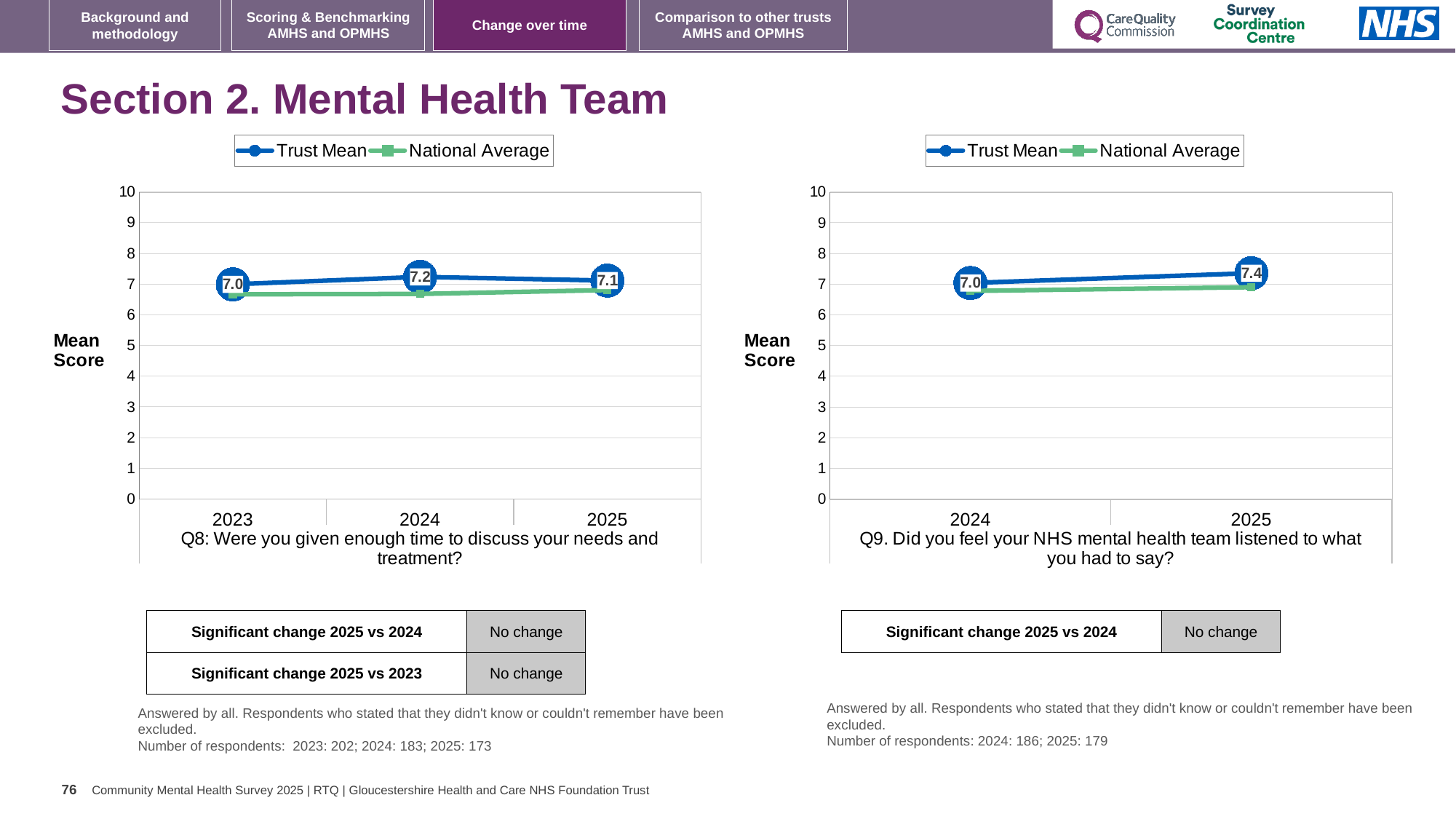
In the Q9 chart on the right, does the Trust Mean rise or fall from 2024 to 2025? rise In the Q9 chart on the right, what is the Trust Mean for 2025? 7.4 How many years are shown on the x axis of the Q8 chart on the left? 3 In the Q8 chart on the left, what is the Trust Mean for 2023? 7.0 In the Q9 chart on the right, what is the difference between the Trust Mean for 2025 and 2024? 0.4 In the Q9 chart on the right, is the National Average for 2025 greater or less than 8? less In the Q8 chart on the left, which year has the highest Trust Mean? 2024 In the Q8 chart on the left, which year has the lowest Trust Mean? 2023 How many series does the legend of the Q9 chart on the right list? 2 What kind of chart is used for Q9 on the right? line chart In the Q8 chart on the left, what is the Trust Mean for 2024? 7.2 In the Q8 chart on the left, is the Trust Mean for 2025 higher or lower than for 2023? higher